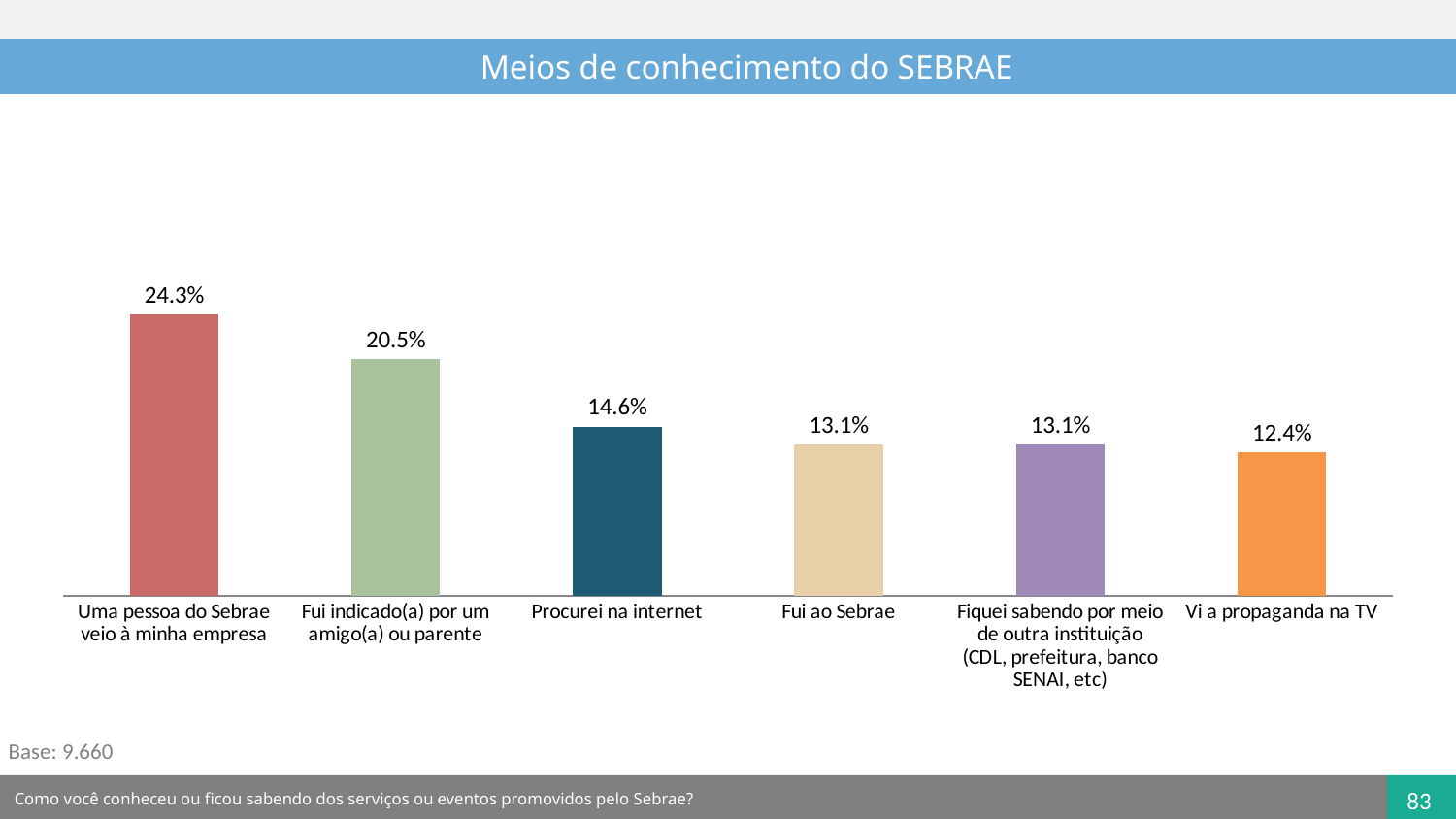
What is the value for "Fui ao Sebrae"? 13.1% What kind of chart is shown on the slide? Bar chart Which is larger, "Fui indicado(a) por um amigo(a) ou parente" or "Procurei na internet"? Fui indicado(a) por um amigo(a) ou parente Which category has the highest value? Uma pessoa do Sebrae veio à minha empresa What is the difference between "Uma pessoa do Sebrae veio à minha empresa" and "Fui indicado(a) por um amigo(a) ou parente"? 3.8% What is the value for "Procurei na internet"? 14.6% What is the value for "Uma pessoa do Sebrae veio à minha empresa"? 24.3% What is the value for "Vi a propaganda na TV"? 12.4% What is the title of the chart? Meios de conhecimento do SEBRAE How many categories are shown in the chart? 6 Which category has the lowest value? Vi a propaganda na TV What is the difference between "Procurei na internet" and "Vi a propaganda na TV"? 2.2%